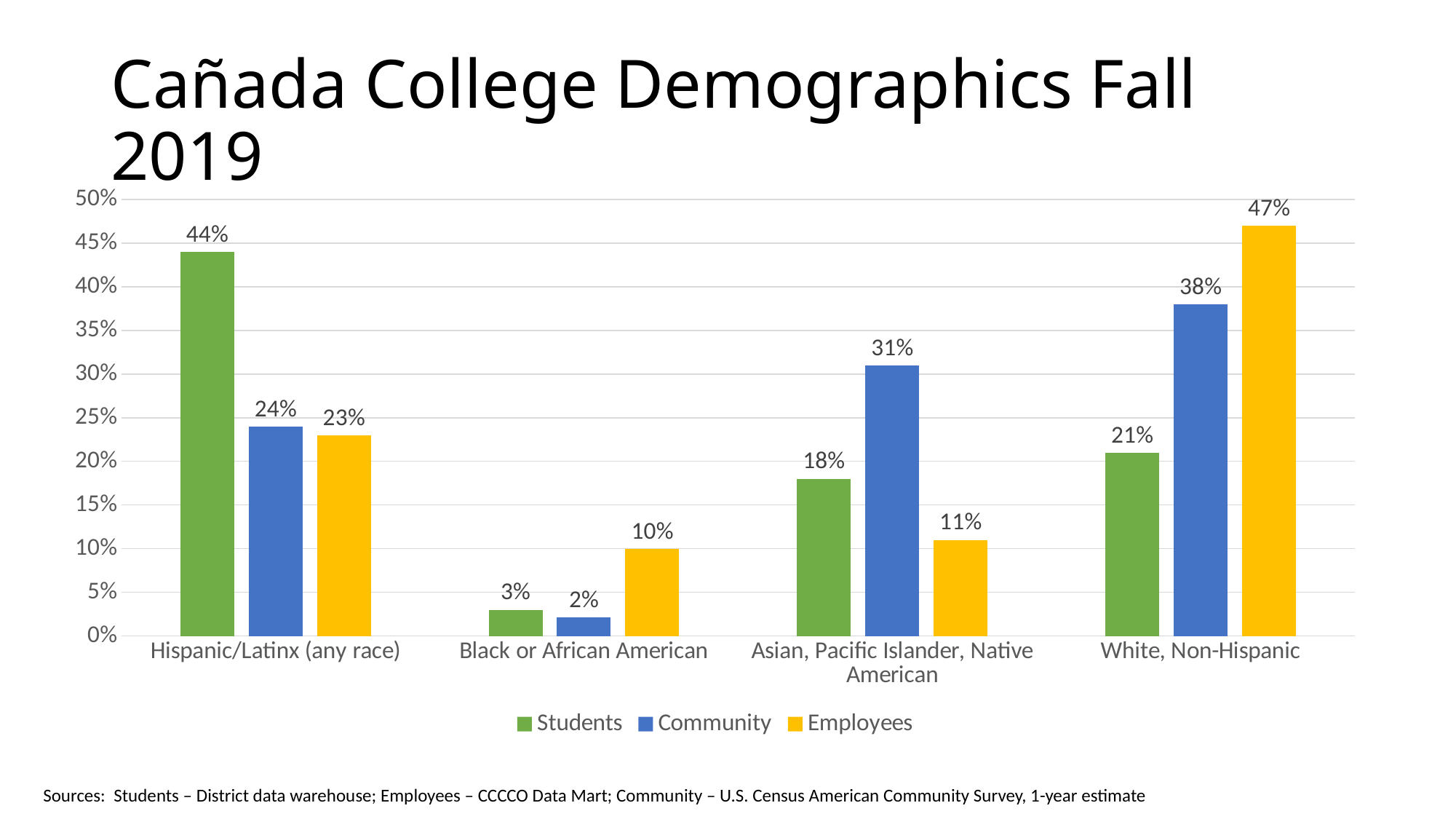
What is the difference between the Students and Community values for Hispanic/Latinx (any race)? 20% Which colour represents the Employees series? Yellow What is the Community value for Asian, Pacific Islander, Native American? 31% How many categories are shown on the x axis? 4 Which is larger for White, Non-Hispanic: the Students value or the Community value? Community What kind of chart is shown on the slide? Bar chart How many series does the legend list? 3 Which category has the highest Students value? Hispanic/Latinx (any race) What percentage of Students are Hispanic/Latinx (any race)? 44% What is the Employees value for White, Non-Hispanic? 47% Which category has the lowest Employees value? Black or African American What is the Community value for Black or African American? 2%